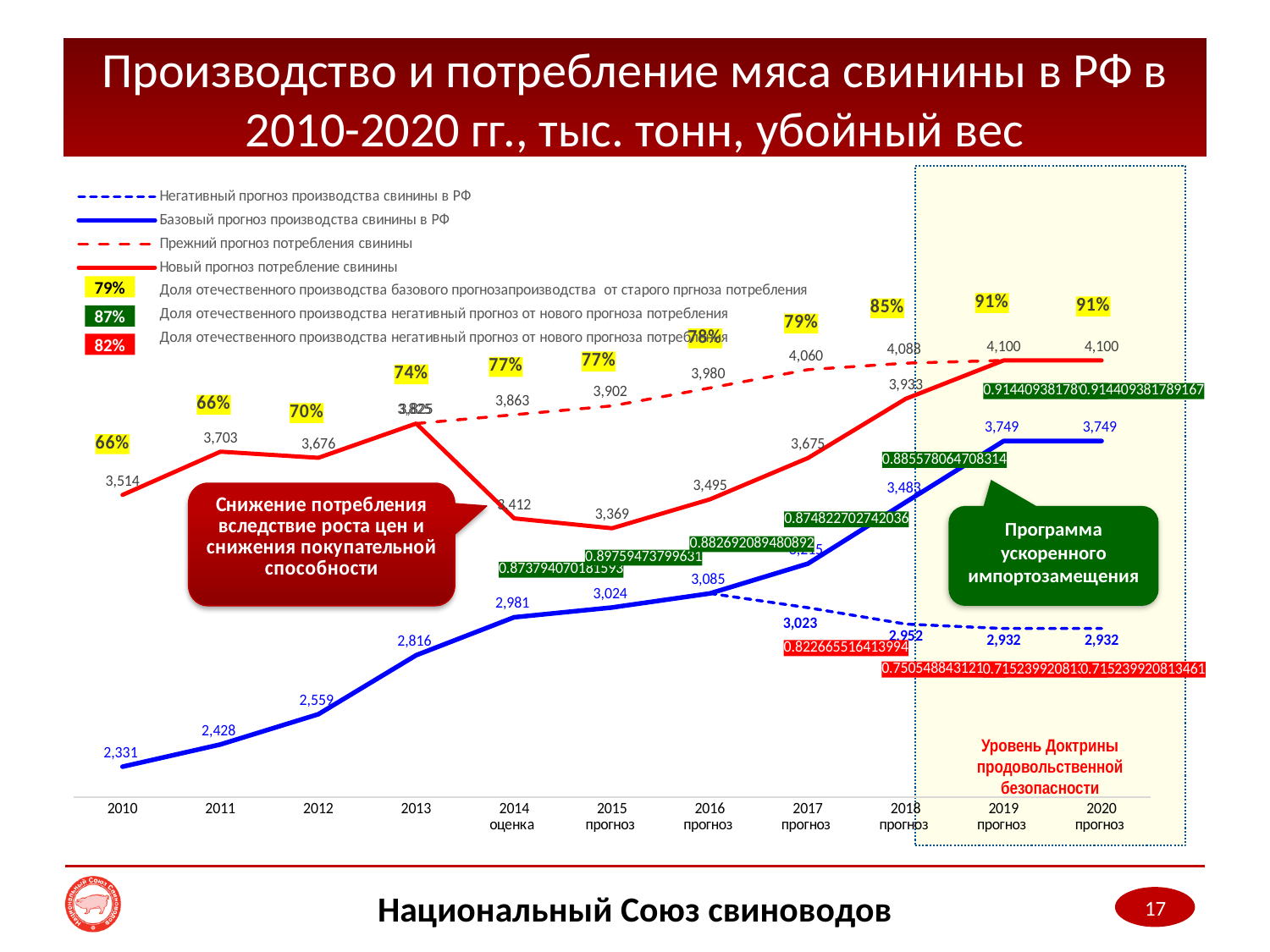
How many line series does the legend list? 4 Does the base production forecast rise or fall from 2010 to 2020? rise By how much does the base production forecast for 2020 exceed the 2010 value? 1,418 What kind of chart is shown on the slide? line chart What is the value of the negative production forecast (Негативный прогноз производства) for 2020? 2,932 What is the value of the new consumption forecast (Новый прогноз потребления) for 2013? 3,825 In 2014, which is higher: the previous consumption forecast or the new consumption forecast? Прежний прогноз потребления (previous consumption forecast) What is the value of the base production forecast (Базовый прогноз производства) for 2010? 2,331 What is the value of the base production forecast (Базовый прогноз производства) for 2020? 3,749 What is the value of the previous consumption forecast (Прежний прогноз потребления) for 2017? 4,060 What is the difference between the new consumption forecast and the base production forecast in 2019? 351 How many years are shown along the x axis? 11